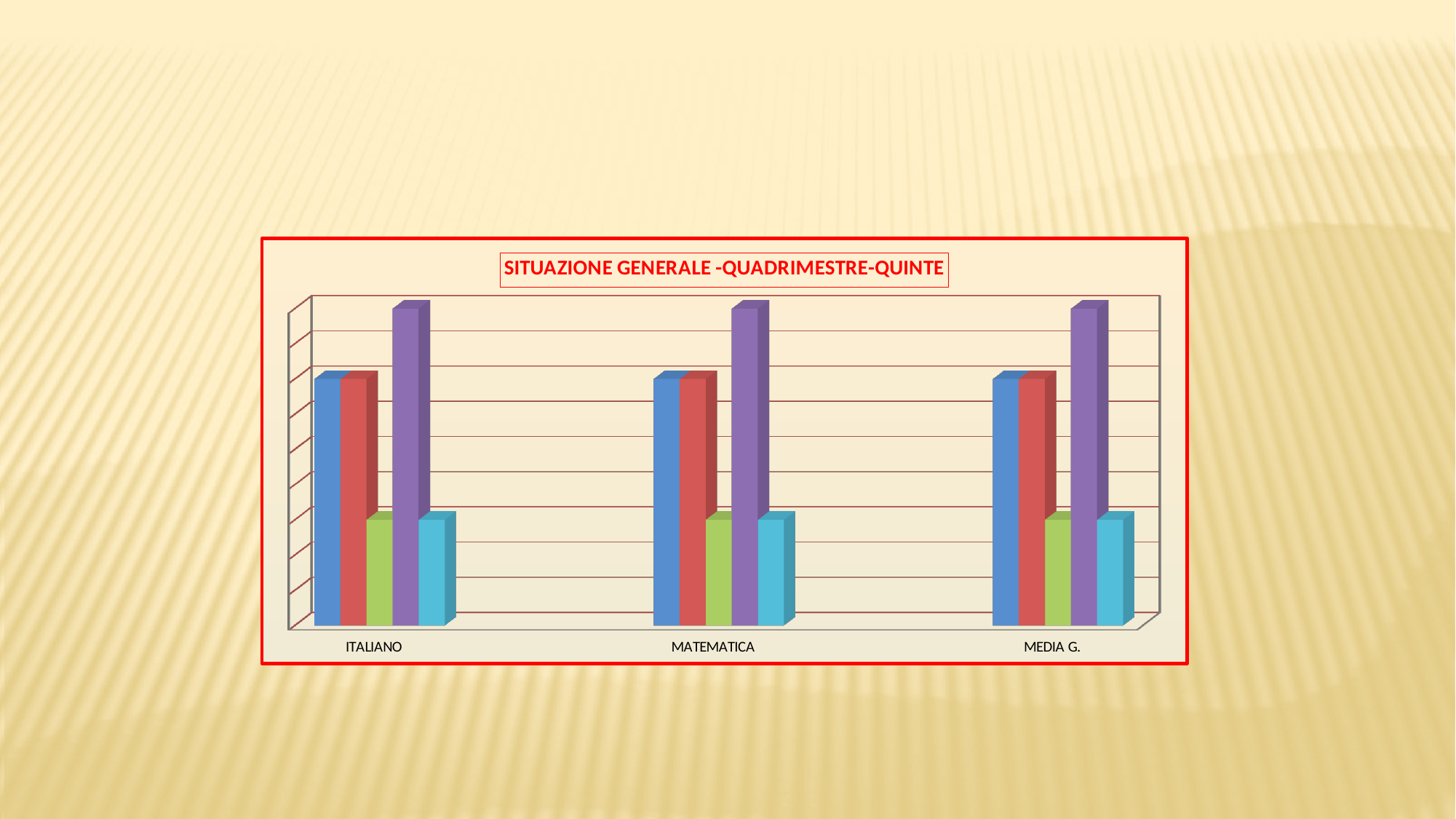
What is the title of the chart? SITUAZIONE GENERALE -QUADRIMESTRE-QUINTE Which colour bar is the tallest in the MEDIA G. group? purple How many bars are plotted for each category in the chart? 5 In the MEDIA G. group, which is taller: the blue bar or the cyan bar? blue What kind of chart is shown on the slide? bar chart Does the chart display a legend identifying the series? No In the MATEMATICA group, which is taller: the purple bar or the green bar? purple How many categories are shown on the x axis of the chart? 3 Which colour bar is the tallest in the ITALIANO group? purple In the ITALIANO group, which is taller: the red bar or the green bar? red